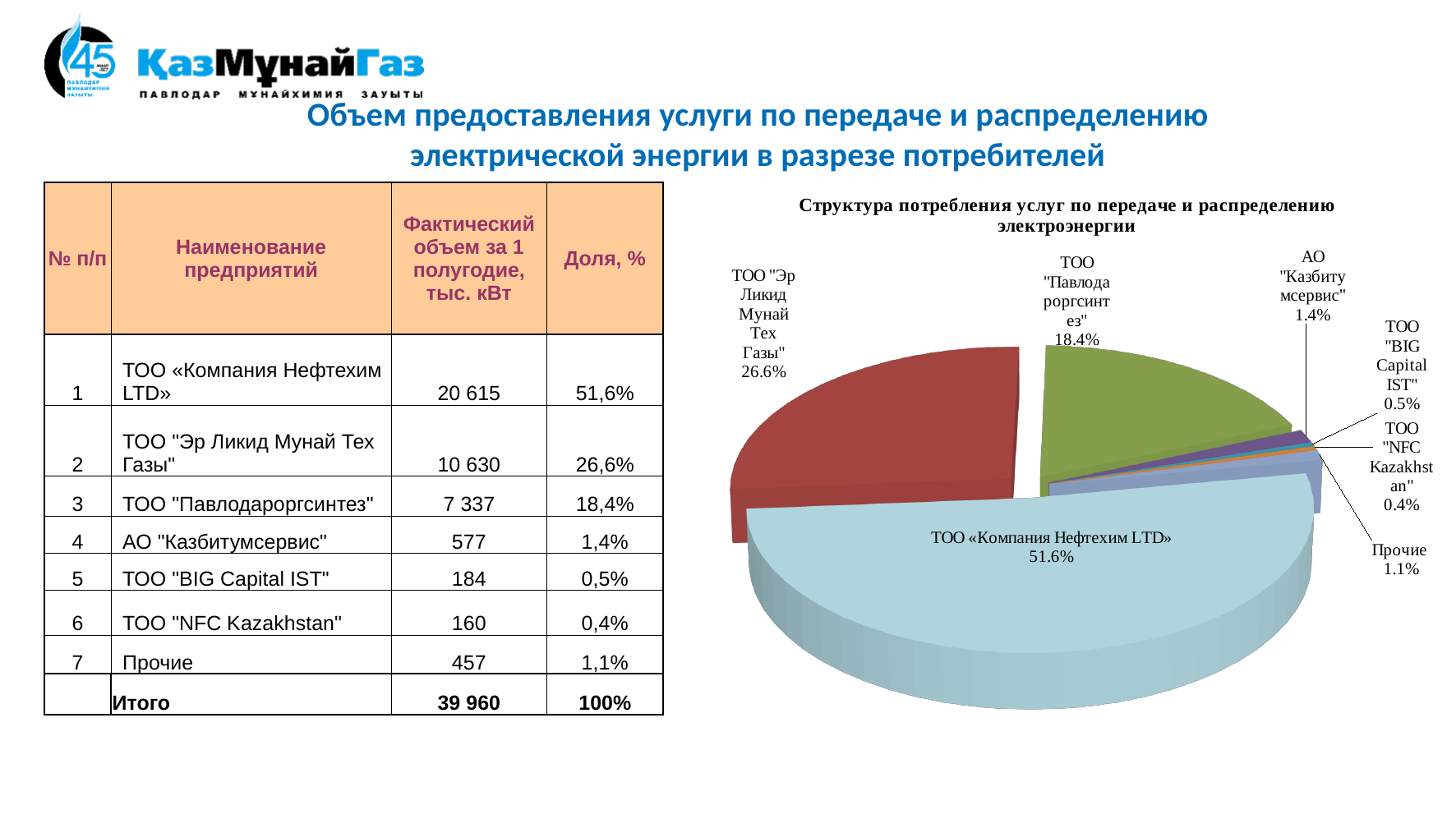
What share of the pie chart does ТОО "NFC Kazakhstan" hold? 0.4% What is the title of the pie chart? Структура потребления услуг по передаче и распределению электроэнергии Which slice of the pie chart is the smallest? ТОО "NFC Kazakhstan" What share of the pie chart does АО "Казбитумсервис" hold? 1.4% What share of the pie chart does ТОО «Компания Нефтехим LTD» hold? 51.6% Which slice of the pie chart is the largest? ТОО «Компания Нефтехим LTD» How many slices does the pie chart have? 7 What kind of chart is shown on the slide? pie chart In the pie chart, what is the difference in share between ТОО "Эр Ликид Мунай Тех Газы" and ТОО "Павлодароргсинтез"? 8.2% In the pie chart, which has the larger share: Прочие or ТОО "BIG Capital IST"? Прочие